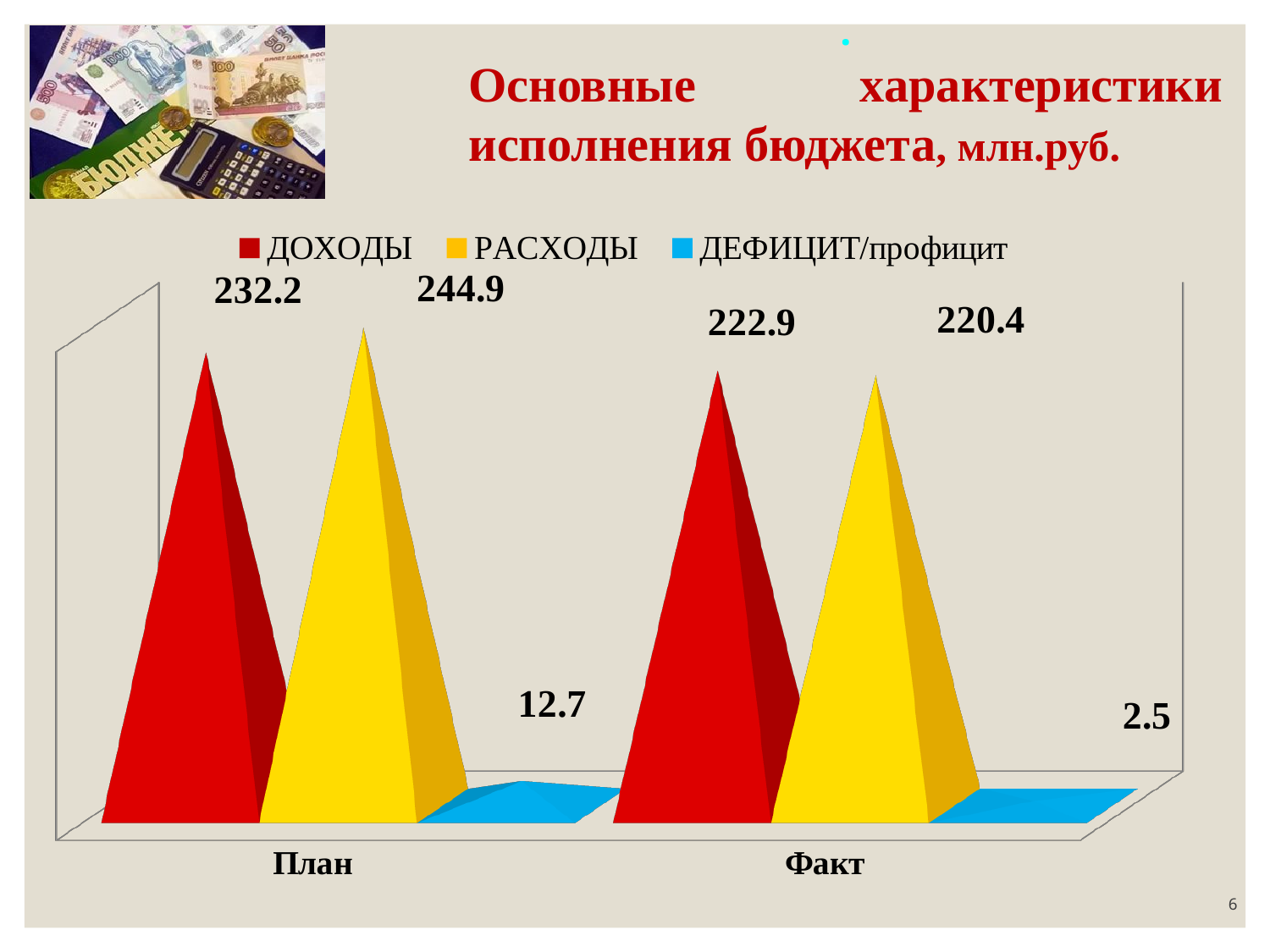
Which colour represents РАСХОДЫ in the chart? Yellow What is the value of ДЕФИЦИТ/профицит for Факт? 2.5 What is the value of ДОХОДЫ for Факт? 222.9 What is the value of ДОХОДЫ for План? 232.2 What is the difference between ДОХОДЫ for План and ДОХОДЫ for Факт? 9.3 What is the value of РАСХОДЫ for План? 244.9 What is the value of ДЕФИЦИТ/профицит for План? 12.7 Which is larger for Факт: ДОХОДЫ or РАСХОДЫ? ДОХОДЫ How many series does the legend list? 3 How many categories are shown on the x axis? 2 What is the value of РАСХОДЫ for Факт? 220.4 What is the difference between РАСХОДЫ and ДОХОДЫ for План? 12.7